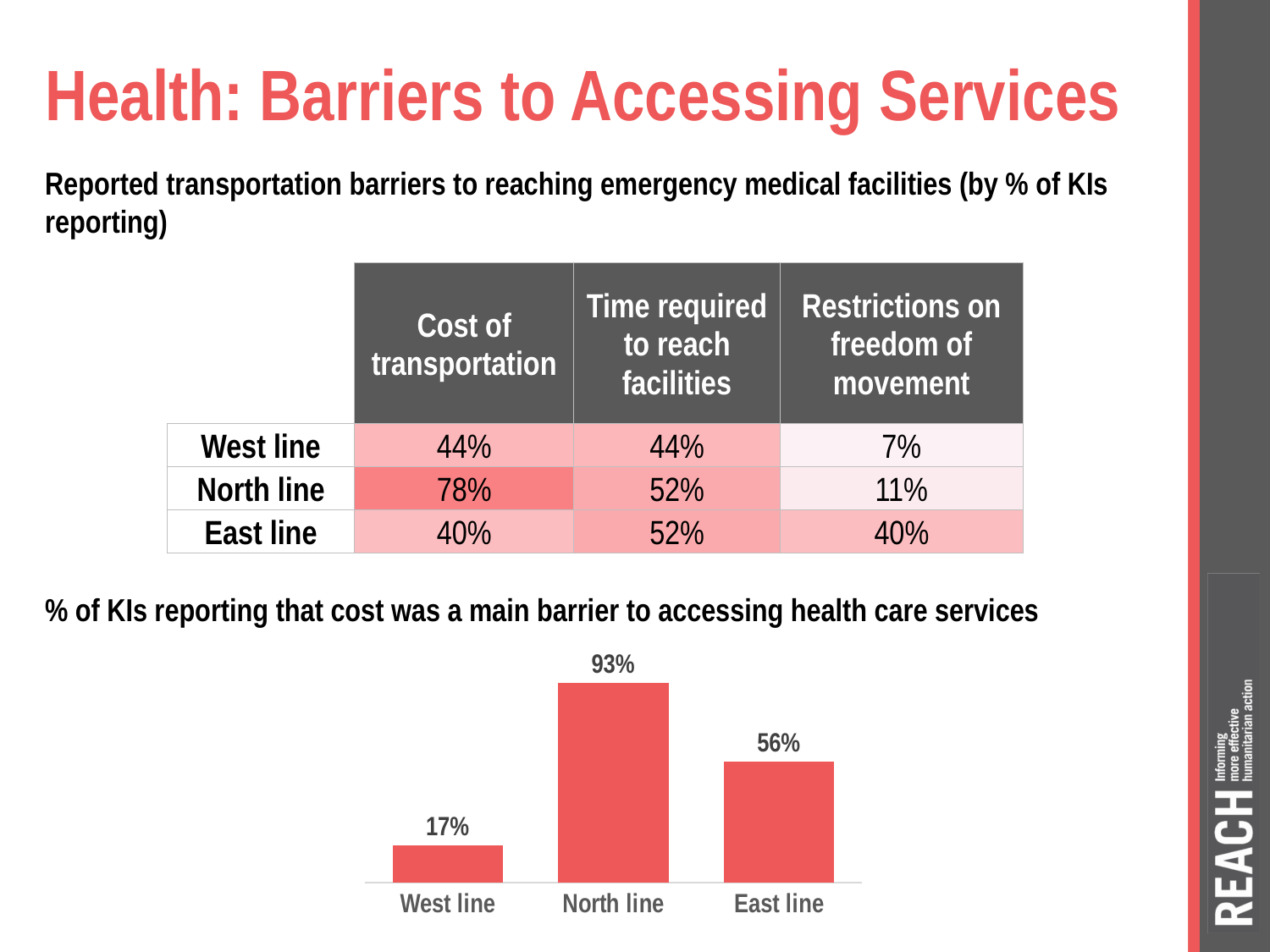
What colour are the bars in the bar chart? Red In the bar chart, what is the difference between the values for North line and East line? 37% What type of chart is shown at the bottom of the slide? Bar chart In the bar chart, which line has the lowest percentage of KIs reporting cost as a main barrier? West line In the bar chart, what percentage of KIs in North line reported that cost was a main barrier to accessing health care services? 93% In the bar chart, which line has the highest percentage of KIs reporting cost as a main barrier? North line How many categories are shown in the bar chart? 3 In the bar chart, what is the difference between the values for East line and West line? 39% In the bar chart, what is the value for West line? 17% What is the title of the bar chart on the slide? % of KIs reporting that cost was a main barrier to accessing health care services In the bar chart, what is the value for East line? 56% In the bar chart, which is larger, the value for East line or the value for West line? East line